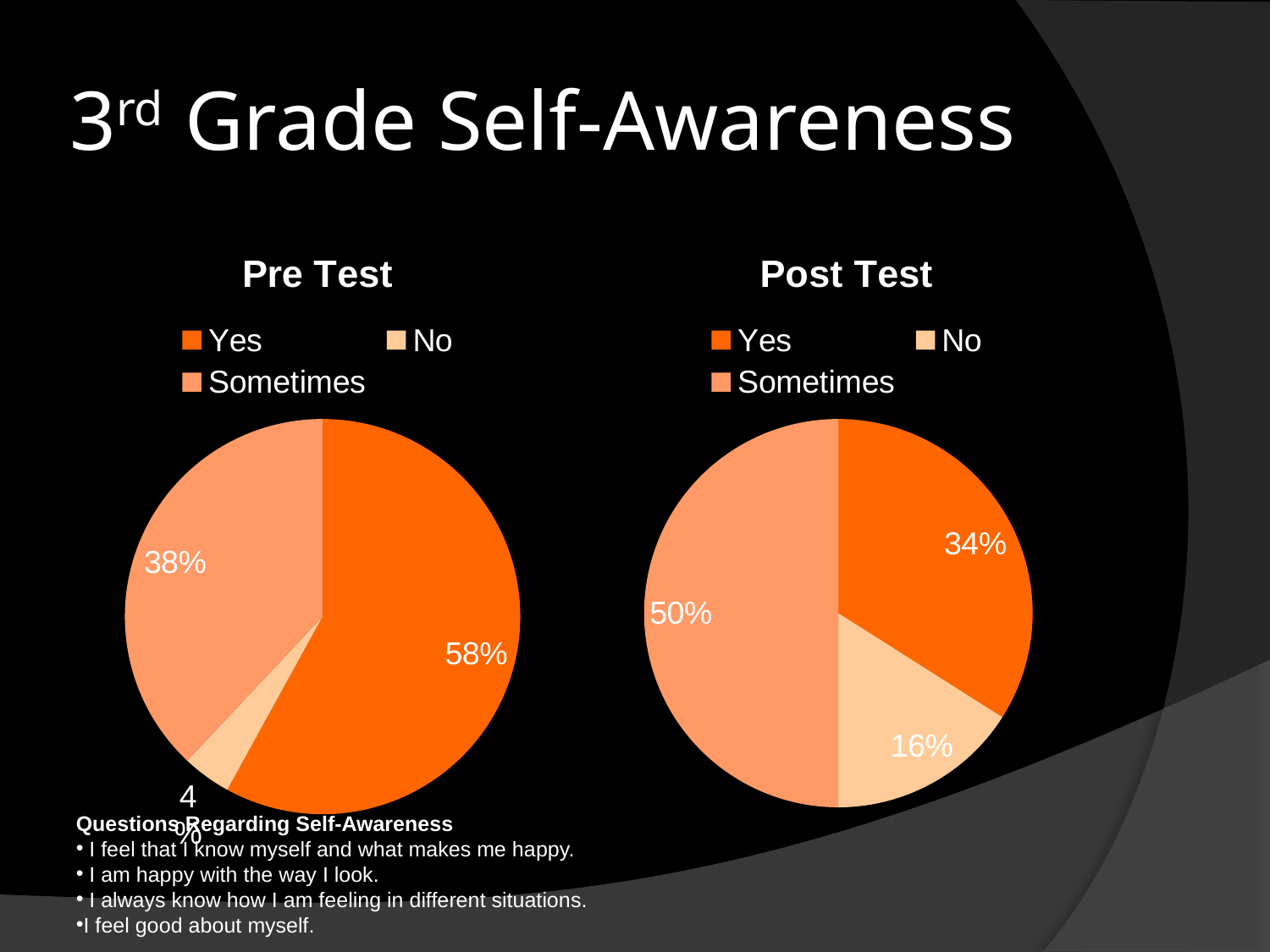
In the Post Test chart, what percentage is shown for Sometimes? 50% In the Post Test chart, which category has the largest slice? Sometimes In the Pre Test chart, what percentage is shown for Yes? 58% Which chart shows a larger value for Yes, Pre Test or Post Test? Pre Test In the Post Test chart, what is the difference between the Sometimes and Yes percentages? 16% What type of chart is the Post Test chart? Pie chart In the Post Test chart, what percentage is shown for Yes? 34% In the Post Test chart, which category has the smallest slice? No How many entries does the legend of the Pre Test chart list? 3 In the Pre Test chart, what percentage is shown for Sometimes? 38% In the Pre Test chart, which category has the largest slice? Yes In the Post Test chart, what percentage is shown for No? 16%